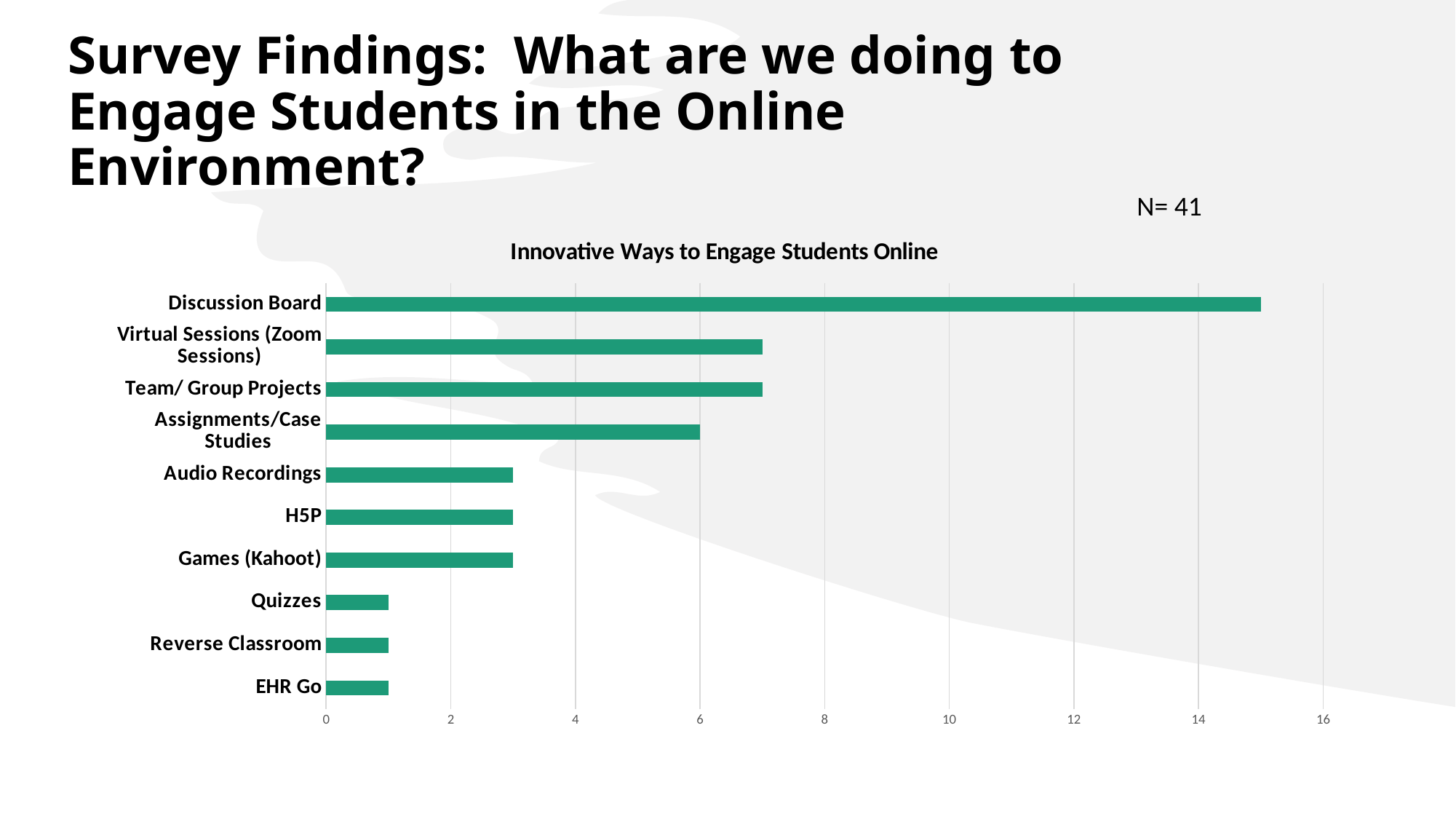
Which category has the highest value? Discussion Board What sample size (N) is stated on the slide? N= 41 Is the value for Virtual Sessions (Zoom Sessions) greater or less than 6? greater Which is larger, the value for Games (Kahoot) or the value for EHR Go? Games (Kahoot) How many categories are plotted in the chart? 10 What is the title of the chart? Innovative Ways to Engage Students Online Which is larger, the value for Discussion Board or the value for Team/ Group Projects? Discussion Board Is the value for Quizzes greater or less than 2? less What kind of chart is shown on the slide? bar chart Is the value for Audio Recordings greater or less than 4? less What is the value for Assignments/Case Studies? 6